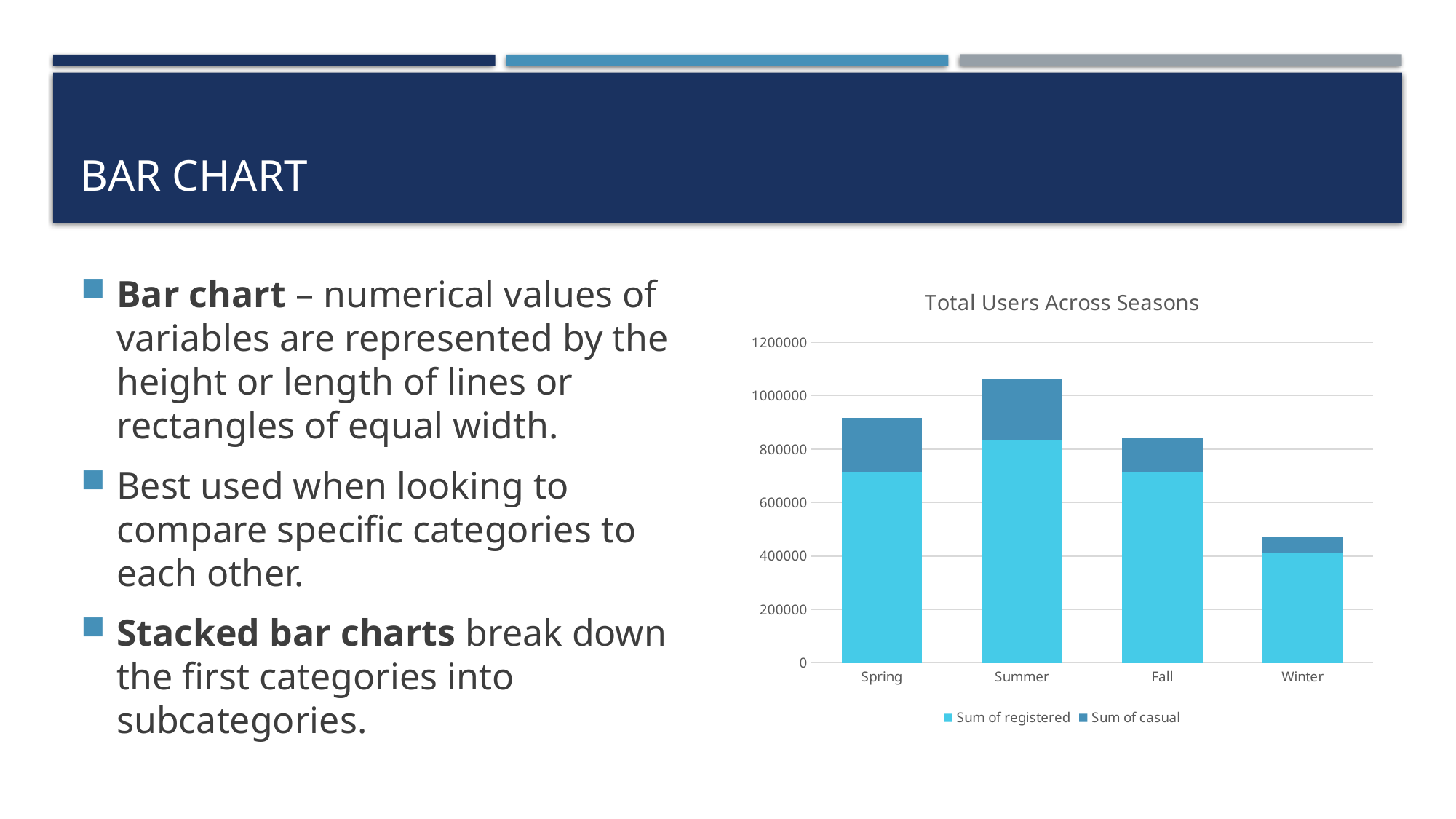
Is the total stacked bar for Summer greater or less than 1000000? greater How many series does the chart's legend list? 2 What are the two series named in the legend? Sum of registered, Sum of casual How many seasons are shown on the x axis of the chart? 4 Which has the larger total stacked bar, Spring or Fall? Spring What kind of chart is shown on the slide? Stacked bar chart Which season has the shortest stacked bar (lowest total users)? Winter What is the title of the chart? Total Users Across Seasons Is the total stacked bar for Winter greater or less than 600000? less Which season has the tallest stacked bar (highest total users)? Summer Is the Sum of registered value for Spring greater or less than 800000? less Which season has the larger Sum of registered value, Summer or Spring? Summer